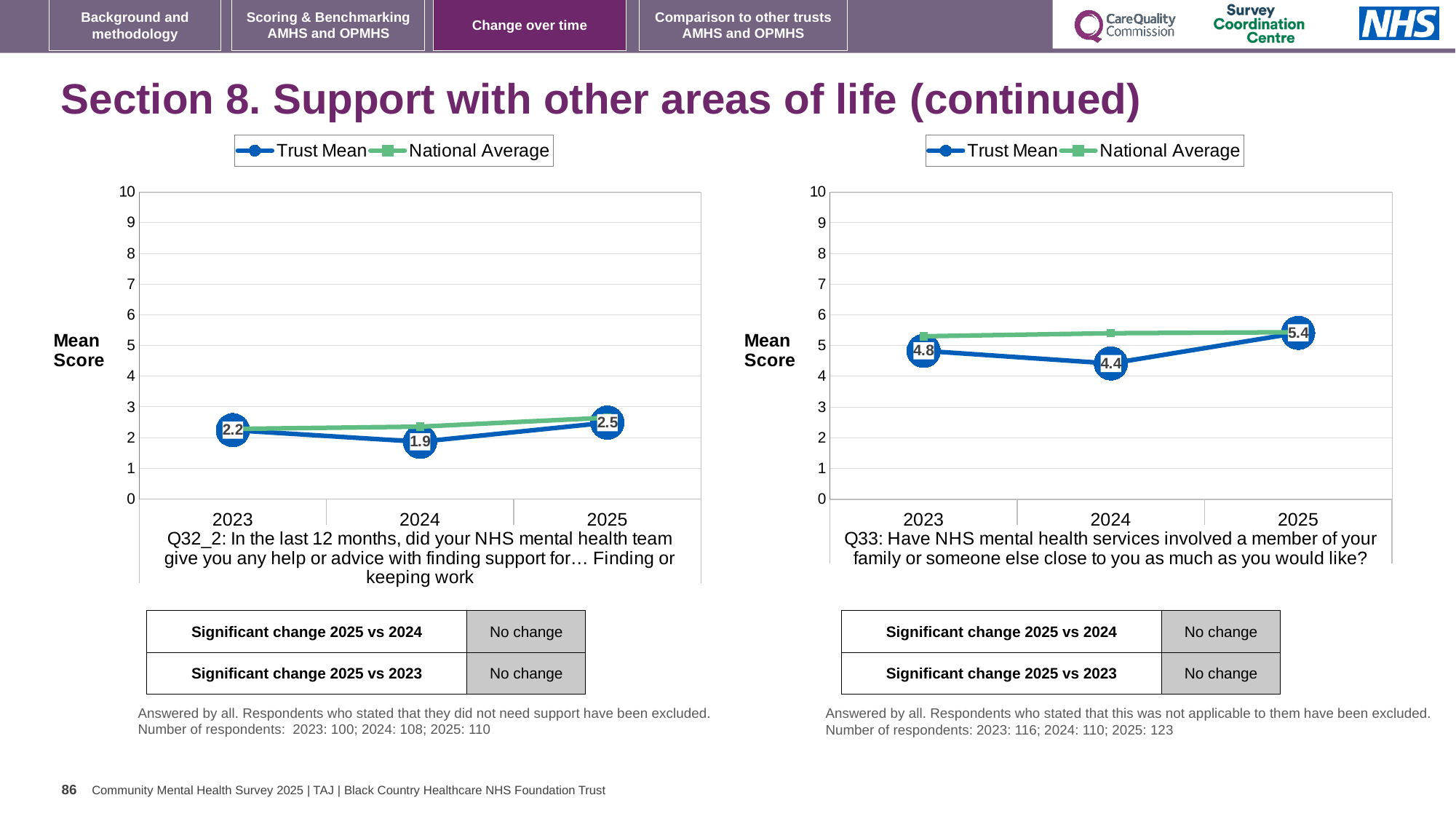
On the left chart (Q32_2), what is the Trust Mean for 2024? 1.9 On the right chart (Q33), is the Trust Mean for 2023 larger or smaller than the Trust Mean for 2024? larger On the left chart (Q32_2), what is the Trust Mean for 2025? 2.5 On the right chart (Q33), what is the difference between the Trust Mean for 2025 and the Trust Mean for 2024? 1.0 How many series does the legend of the left chart (Q32_2) list? 2 On the right chart (Q33), what is the Trust Mean for 2023? 4.8 What kind of chart is the right chart (Q33)? line chart On the right chart (Q33), what is the Trust Mean for 2025? 5.4 On the left chart (Q32_2), which year has the lowest Trust Mean? 2024 On the right chart (Q33), which year has the highest Trust Mean? 2025 On the left chart (Q32_2), what is the difference between the Trust Mean for 2025 and the Trust Mean for 2024? 0.6 On the right chart (Q33), is the National Average for 2024 greater or less than 5? greater